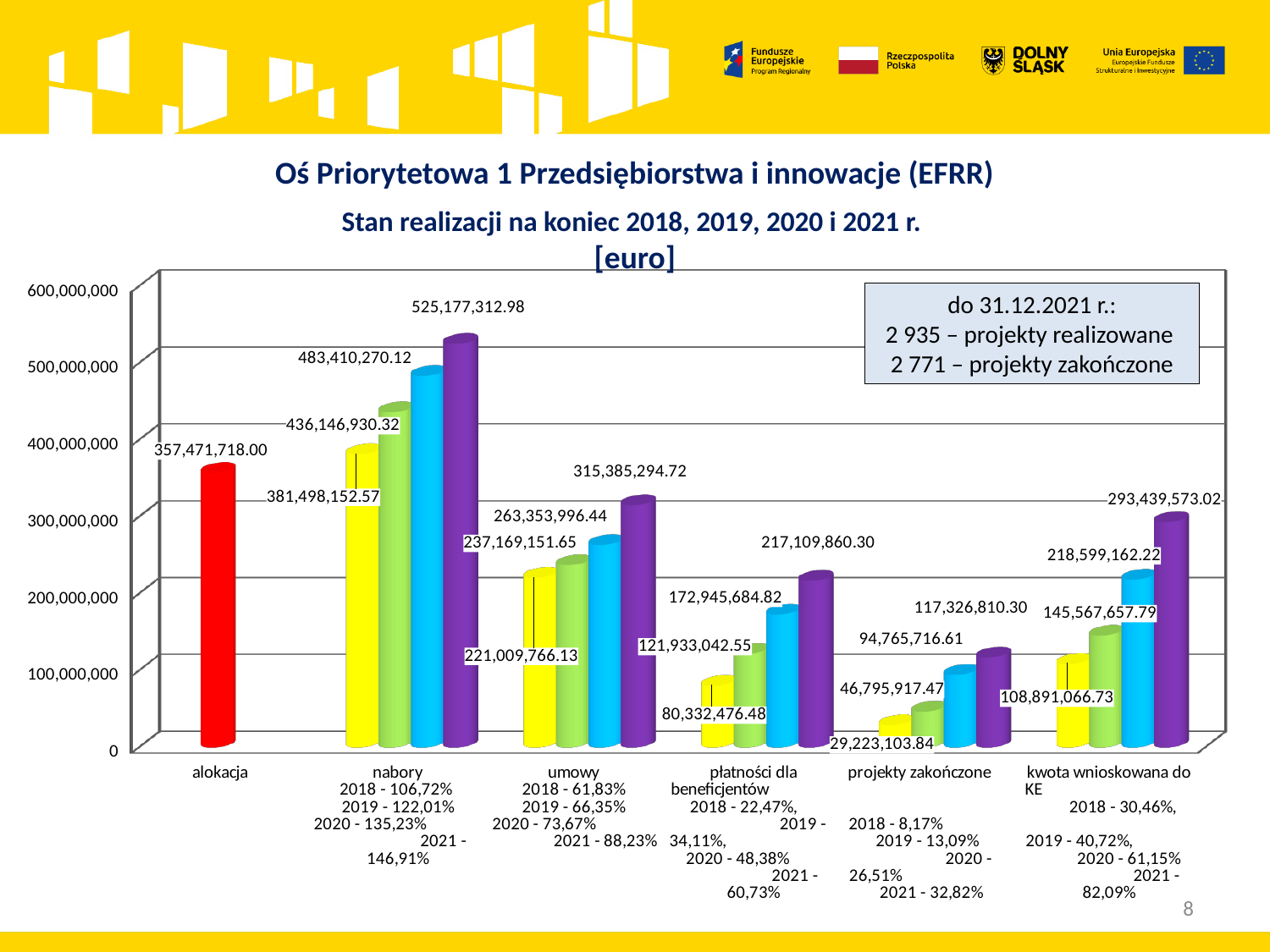
What unit is given in the chart title? euro What is the value of the tallest bar in the kwota wnioskowana do KE group? 293,439,573.02 What is the value of the shortest bar in the płatności dla beneficjentów group? 80,332,476.48 How many categories are shown along the x axis of the chart? 6 What is the difference between the tallest nabory bar (525,177,312.98) and the alokacja bar (357,471,718.00)? 167,705,594.98 Which is larger: the tallest bar in the umowy group or the tallest bar in the płatności dla beneficjentów group? umowy What is the value of the shortest bar in the projekty zakończone group? 29,223,103.84 What is the value of the alokacja bar? 357,471,718.00 What type of chart is shown on the slide? bar chart Is the value of the tallest bar in the projekty zakończone group greater or less than 200,000,000? less Within the umowy group, do the bars rise or fall from left to right? rise What is the value of the tallest bar in the nabory group? 525,177,312.98